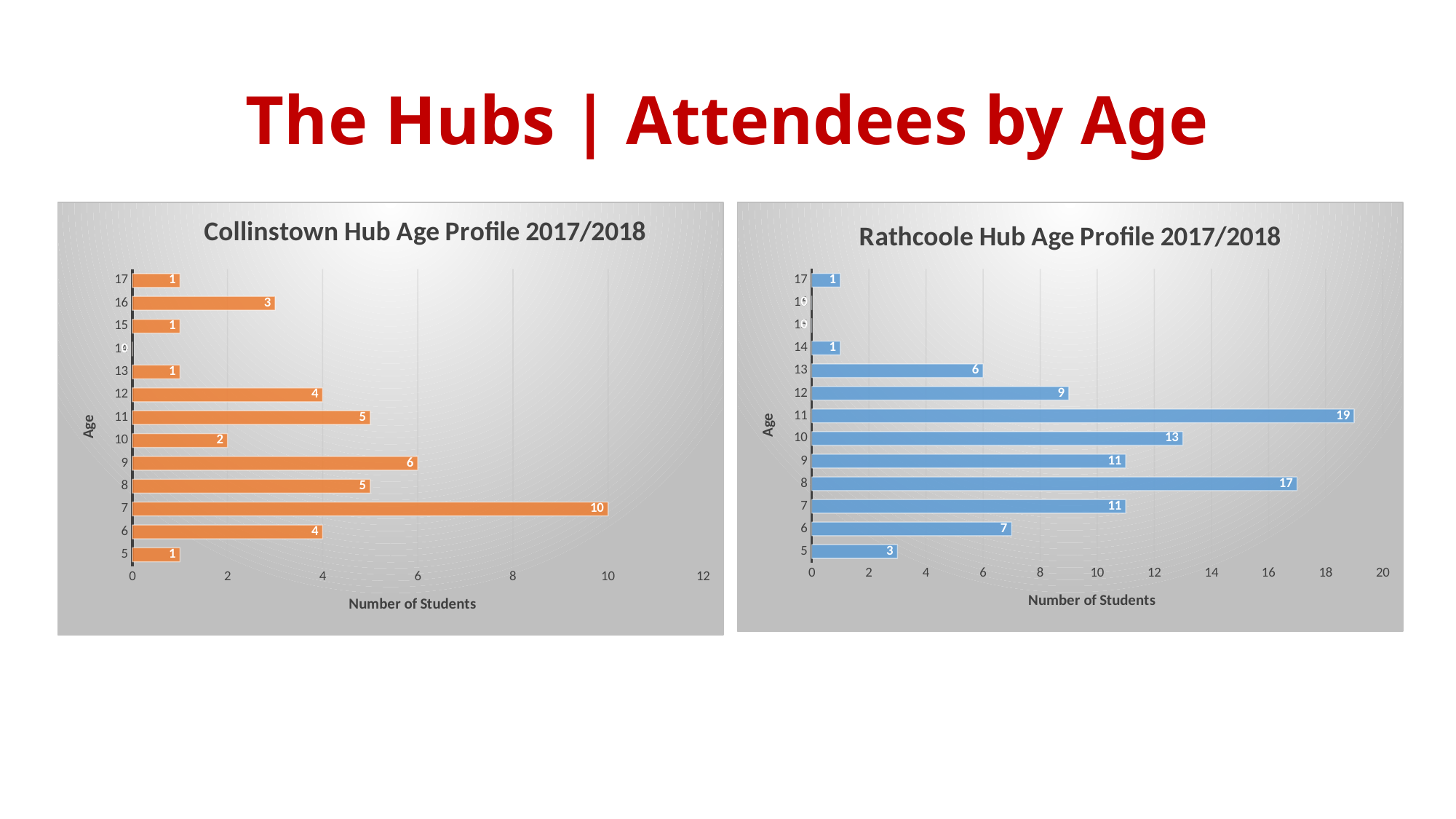
In the Rathcoole Hub Age Profile 2017/2018 chart, which age has the most students? 11 In the Collinstown Hub Age Profile 2017/2018 chart, how many students are aged 7? 10 In the Rathcoole Hub Age Profile 2017/2018 chart, how many students are aged 5? 3 What colour are the bars in the Rathcoole Hub Age Profile 2017/2018 chart? Blue In the Collinstown Hub Age Profile 2017/2018 chart, which age has the most students? 7 In the Collinstown Hub Age Profile 2017/2018 chart, which age has more students, 16 or 12? 12 In the Rathcoole Hub Age Profile 2017/2018 chart, how many students are aged 11? 19 In the Collinstown Hub Age Profile 2017/2018 chart, what is the difference between the number of students aged 9 and aged 10? 4 In the Rathcoole Hub Age Profile 2017/2018 chart, what is the difference between the number of students aged 8 and aged 6? 10 What type of chart is the Collinstown Hub Age Profile 2017/2018 chart? Bar chart What is the label of the horizontal axis in the Rathcoole Hub Age Profile 2017/2018 chart? Number of Students In the Rathcoole Hub Age Profile 2017/2018 chart, which age has more students, 10 or 12? 10